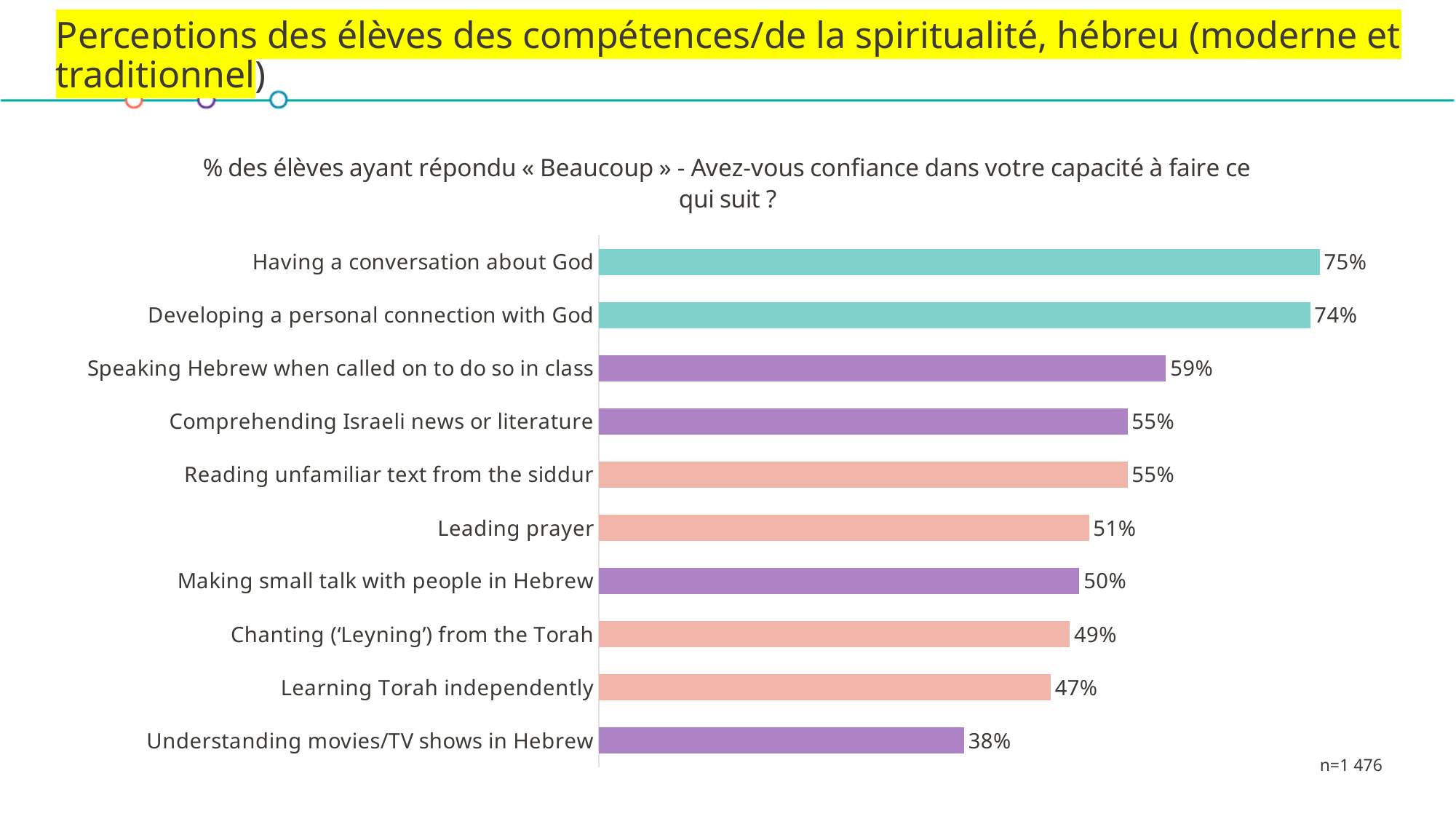
What is the value shown for 'Comprehending Israeli news or literature'? 55% Which is larger: the value for 'Chanting (‘Leyning’) from the Torah' or the value for 'Learning Torah independently'? Chanting (‘Leyning’) from the Torah What is the value shown for 'Understanding movies/TV shows in Hebrew'? 38% How many categories are shown in the chart? 10 What kind of chart is shown on the slide? Bar chart What percentage of students answered « Beaucoup » for 'Having a conversation about God'? 75% Which category has the highest value in the chart? Having a conversation about God Which category has the lowest value in the chart? Understanding movies/TV shows in Hebrew What is the value shown for 'Leading prayer'? 51% What is the difference between the values for 'Speaking Hebrew when called on to do so in class' and 'Making small talk with people in Hebrew'? 9% What is the difference between the values for 'Having a conversation about God' and 'Understanding movies/TV shows in Hebrew'? 37% What sample size (n) is indicated on the slide? n=1 476